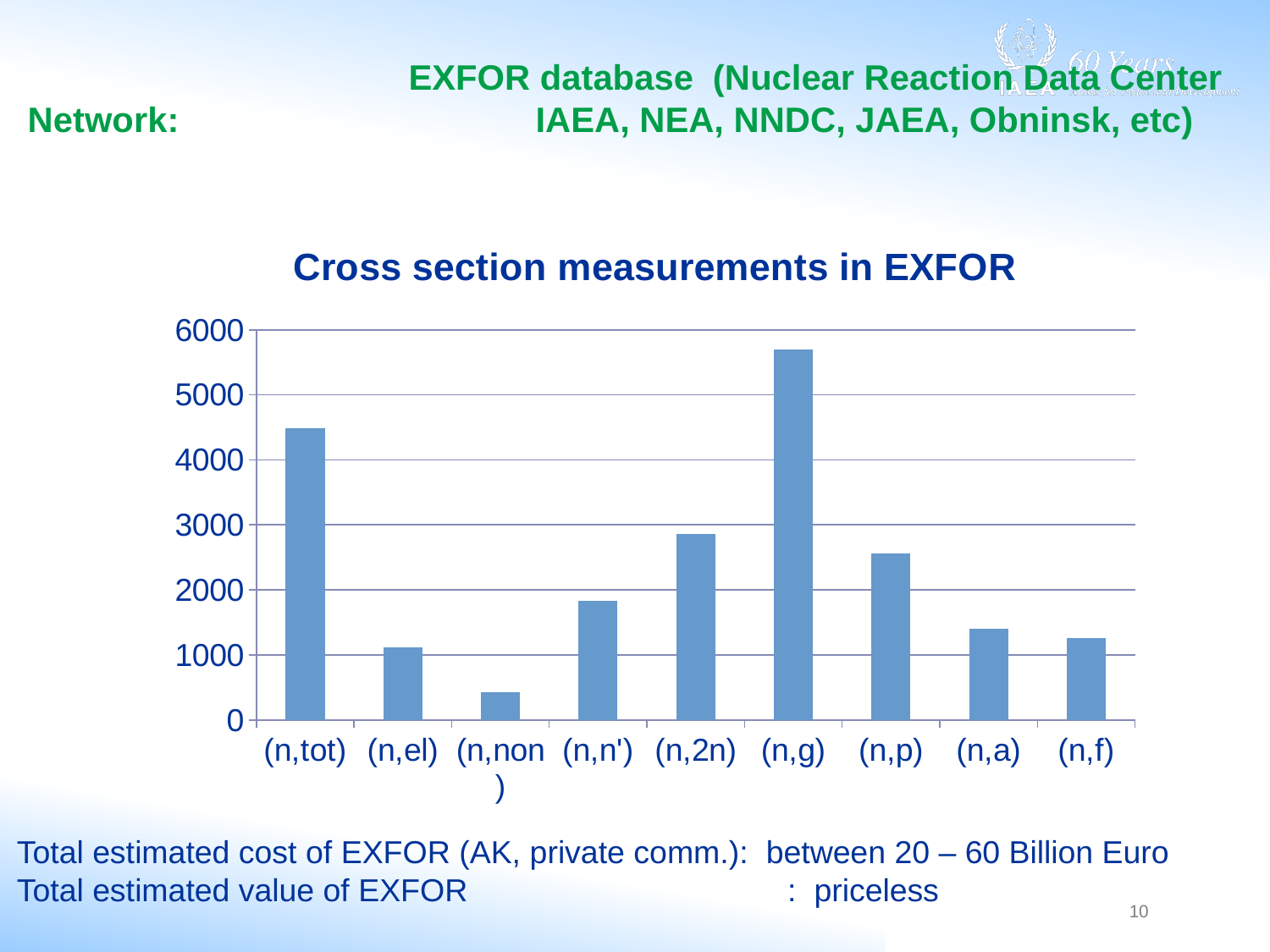
How many categories are shown on the x axis of the chart? 9 What is the title of the chart? Cross section measurements in EXFOR Which is larger, the value for (n,el) or the value for (n,n')? (n,n') What is the maximum value shown on the y axis of the chart? 6000 What kind of chart is shown on the slide? bar chart Is the value for (n,non) greater or less than 1000? less Which is larger, the value for (n,tot) or the value for (n,2n)? (n,tot) Is the value for (n,tot) greater or less than 4000? greater Which category has the lowest value in the chart? (n,non) Is the value for (n,g) greater or less than 5000? greater Which category has the highest value in the chart? (n,g)